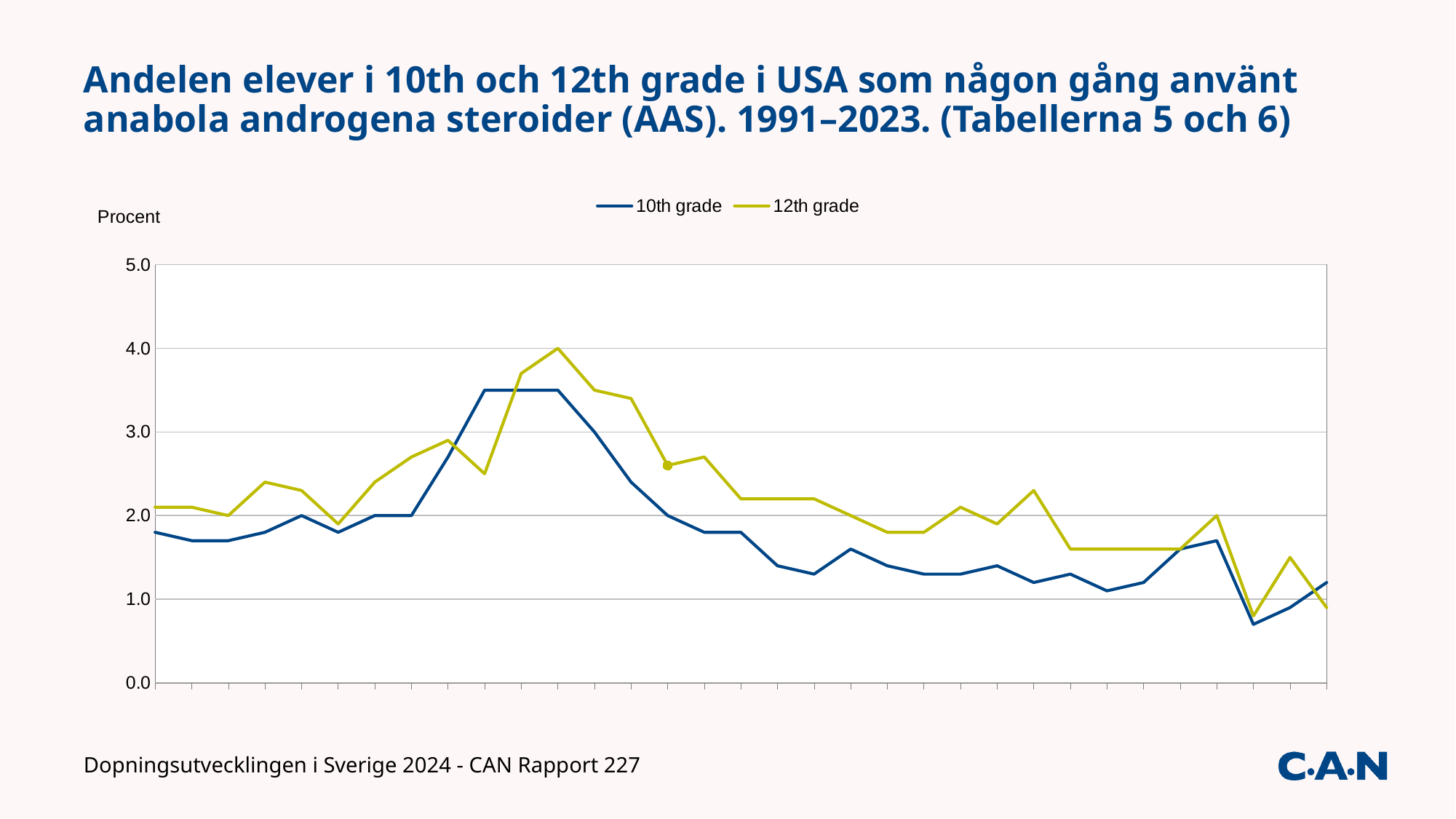
How many series does the legend list? 2 What is the label on the vertical axis? Procent What kind of chart is shown on the slide? Line chart Is the first value of the 12th grade line greater or less than 2.0? greater Is the lowest value of the 12th grade line greater or less than 1.0? less Which series reaches the higher peak value, 10th grade or 12th grade? 12th grade Does the 10th grade line end higher or lower than it starts? lower Is the peak value of the 10th grade line greater or less than 3.0? greater What are the two series named in the legend? 10th grade and 12th grade After reaching its peak, does the 12th grade line generally rise or fall towards the right end of the chart? fall